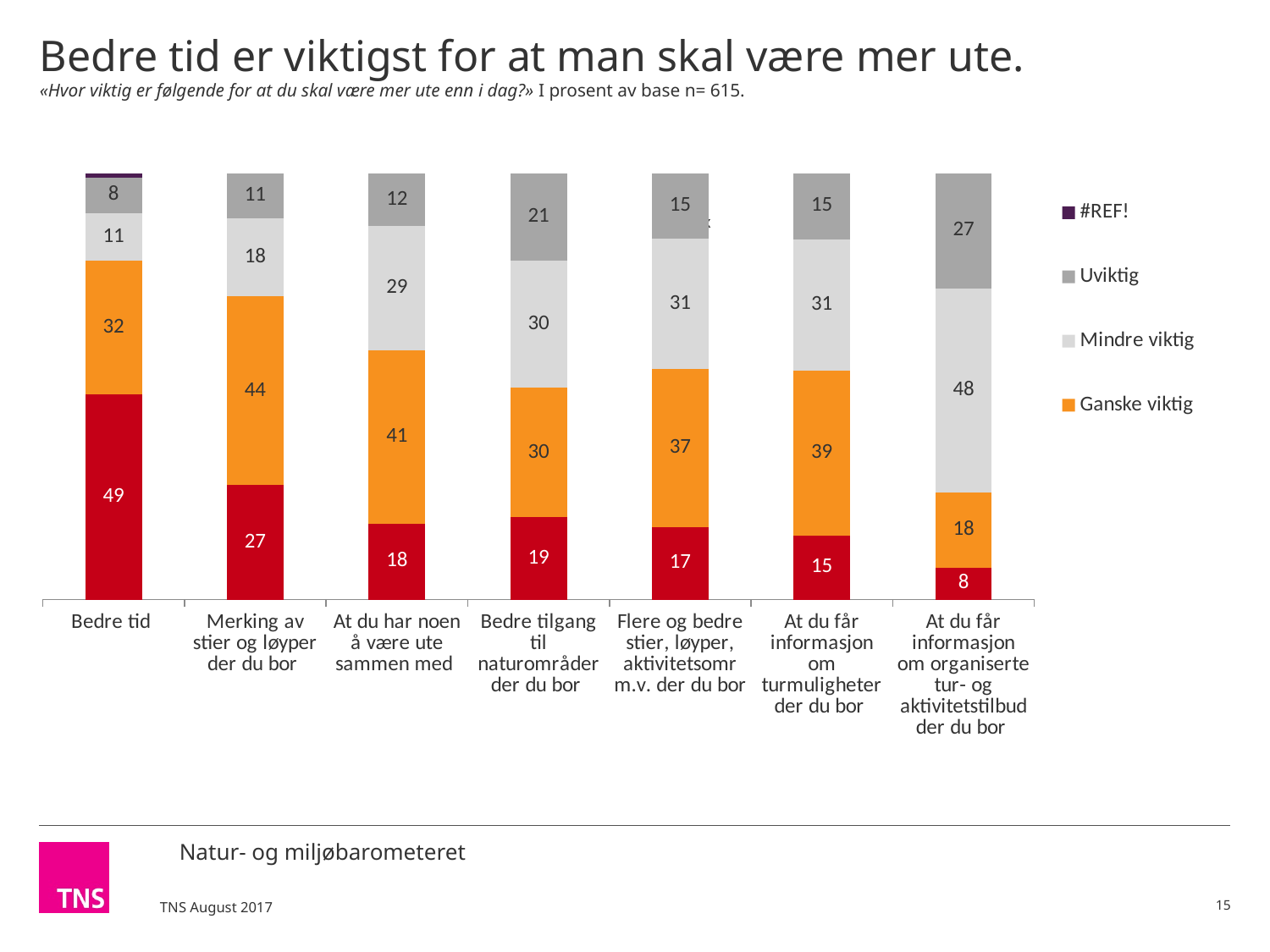
What is the 'Mindre viktig' value for 'At du har noen å være ute sammen med'? 29 Which category has the lowest value in the red bottom segment? At du får informasjon om organiserte tur- og aktivitetstilbud der du bor What kind of chart is shown on the slide? Stacked bar chart Which has the larger 'Uviktig' value: 'Bedre tilgang til naturområder der du bor' or 'Flere og bedre stier, løyper, aktivitetsomr m.v. der du bor'? Bedre tilgang til naturområder der du bor How many categories are shown along the x axis of the chart? 7 What is the difference between the 'Ganske viktig' values for 'Merking av stier og løyper der du bor' and 'Bedre tid'? 12 What is the first entry listed in the legend? #REF! What is the 'Uviktig' value for 'At du får informasjon om organiserte tur- og aktivitetstilbud der du bor'? 27 What is the total of the stacked bar for 'Merking av stier og løyper der du bor'? 100 How many series does the legend list? 4 Which category has the highest 'Mindre viktig' value? At du får informasjon om organiserte tur- og aktivitetstilbud der du bor What is the 'Ganske viktig' value for 'Merking av stier og løyper der du bor'? 44